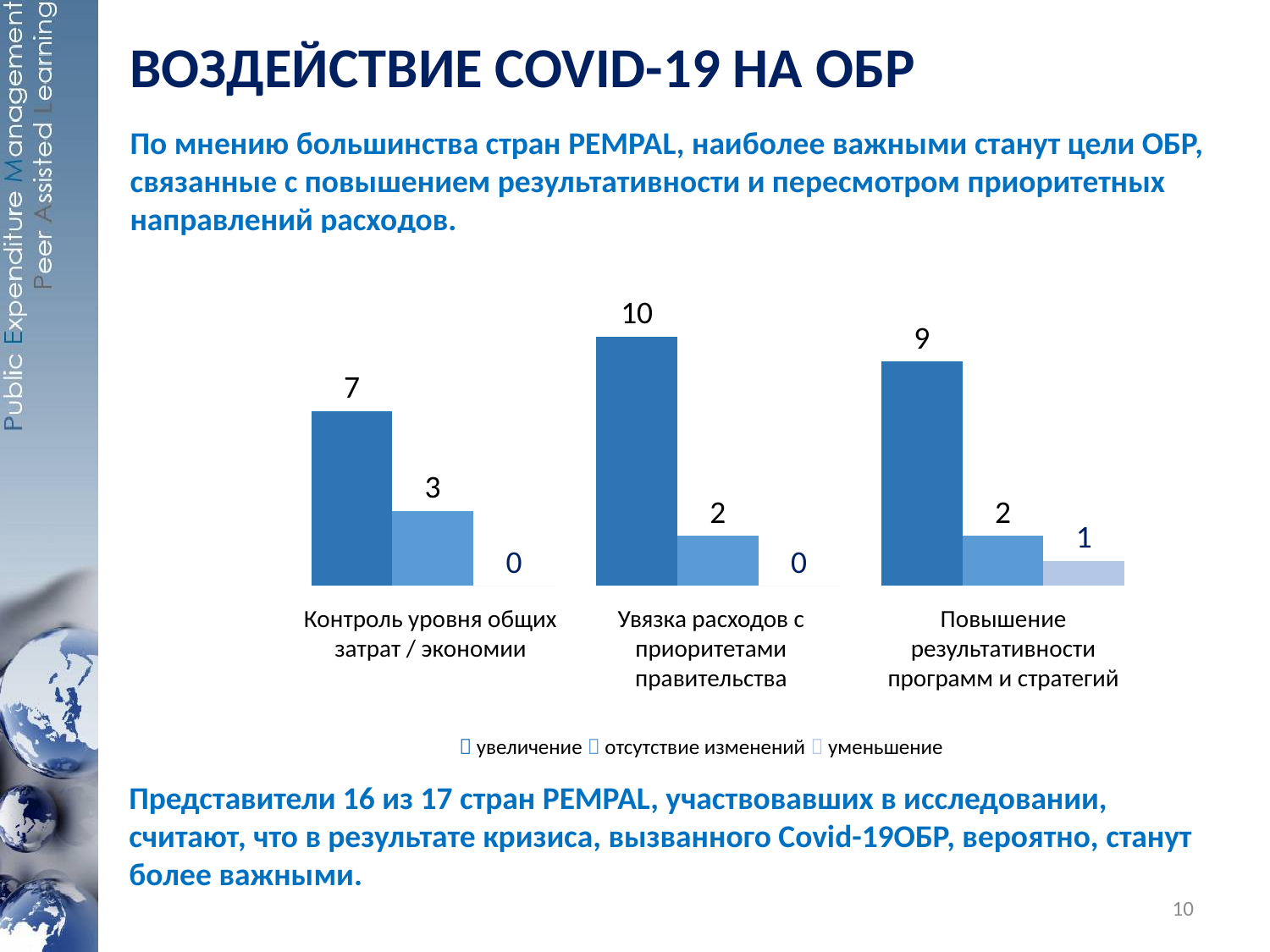
What is the total of the three series values for 'Повышение результативности программ и стратегий'? 12 What is the difference between the 'увеличение' values for 'Увязка расходов с приоритетами правительства' and 'Контроль уровня общих затрат / экономии'? 3 Which category has the highest value for 'увеличение'? Увязка расходов с приоритетами правительства What is the value of 'увеличение' for 'Увязка расходов с приоритетами правительства'? 10 What type of chart is shown on the slide? bar chart Which category has the lowest value for 'увеличение'? Контроль уровня общих затрат / экономии Which is larger: the 'увеличение' value for 'Повышение результативности программ и стратегий' or for 'Контроль уровня общих затрат / экономии'? Повышение результативности программ и стратегий How many series does the chart legend list? 3 What is the value of 'уменьшение' for 'Повышение результативности программ и стратегий'? 1 What is the value of 'отсутствие изменений' for 'Контроль уровня общих затрат / экономии'? 3 How many categories are shown on the x axis of the chart? 3